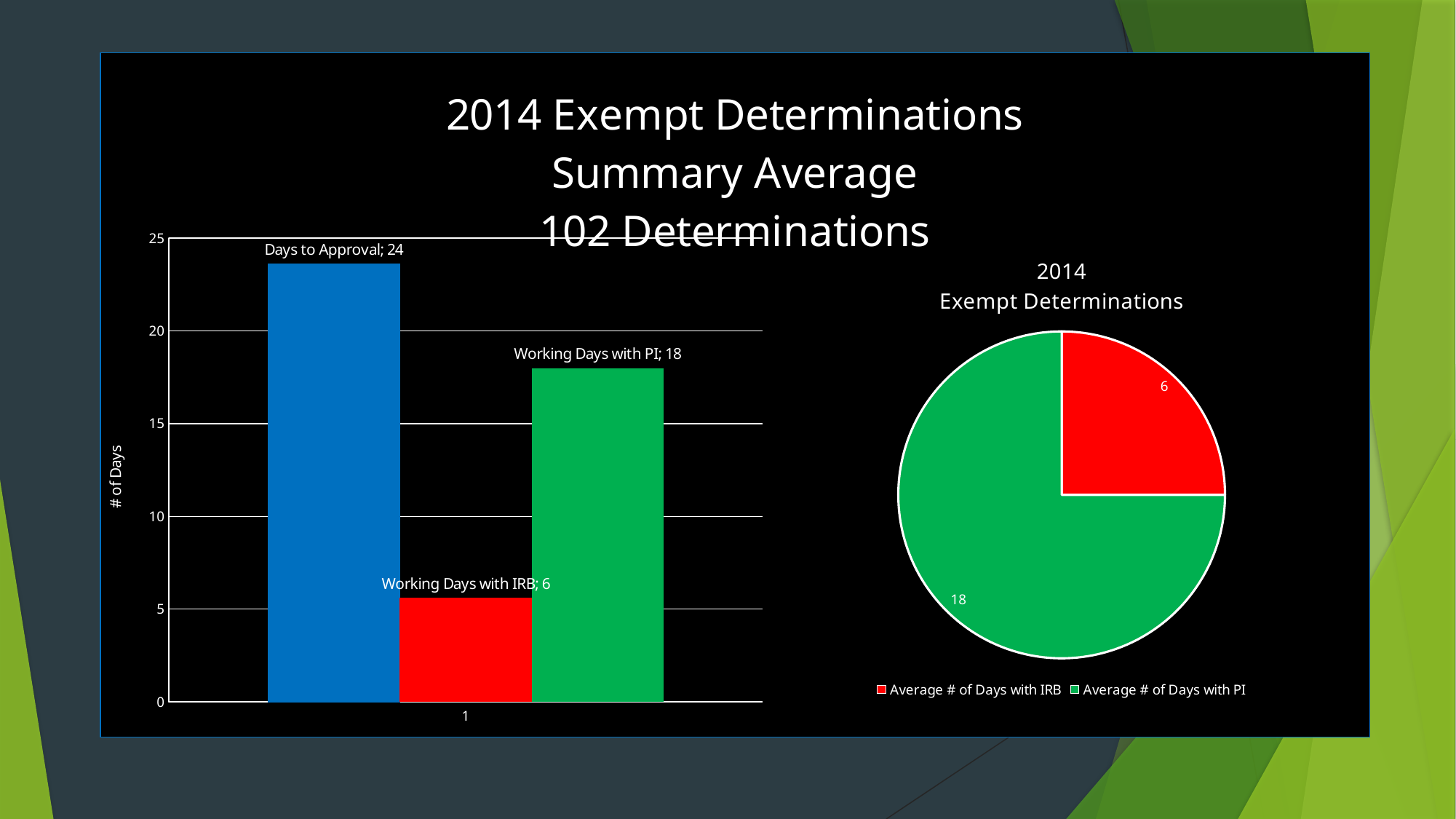
In the bar chart on the left, what is the value for Working Days with IRB? 6 In the bar chart on the left, what is the difference between Days to Approval and Working Days with PI? 6 How many series does the legend of the pie chart titled '2014 Exempt Determinations' list? 2 In the bar chart on the left, which bar has the highest value? Days to Approval What kind of chart is the chart on the left of the slide? Bar chart In the bar chart on the left, what is the value for Working Days with PI? 18 In the bar chart on the left, which bar has the lowest value? Working Days with IRB How many bars are plotted in the bar chart on the left? 3 In the bar chart on the left, what is the value for Days to Approval? 24 In the pie chart titled '2014 Exempt Determinations', what is the value of the Average # of Days with IRB slice? 6 In the pie chart titled '2014 Exempt Determinations', what share of the pie does the Average # of Days with PI slice represent? 75% In the bar chart on the left, which is larger: Working Days with PI or Working Days with IRB? Working Days with PI